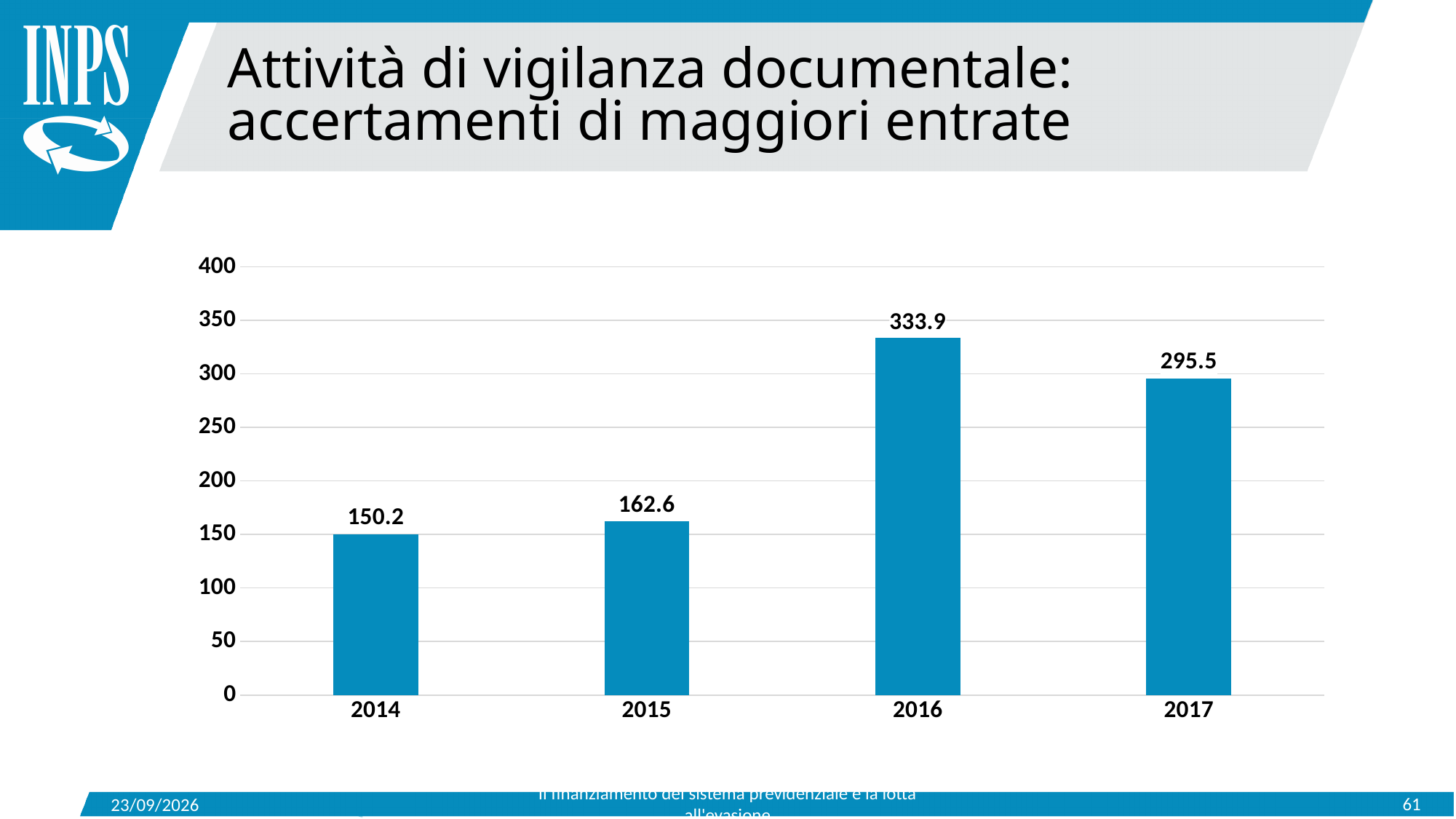
What kind of chart is shown on the slide? Bar chart What is the value for 2017? 295.5 What is the difference between the values for 2016 and 2017? 38.4 Does the value rise or fall from 2016 to 2017? Fall How many years are shown on the x axis? 4 What is the value for 2014? 150.2 Is the value for 2017 greater or less than 250? greater Which is larger, the value for 2015 or the value for 2017? 2017 What is the value for 2016? 333.9 What is the difference between the values for 2015 and 2014? 12.4 Which year has the lowest value? 2014 Which year has the highest value? 2016